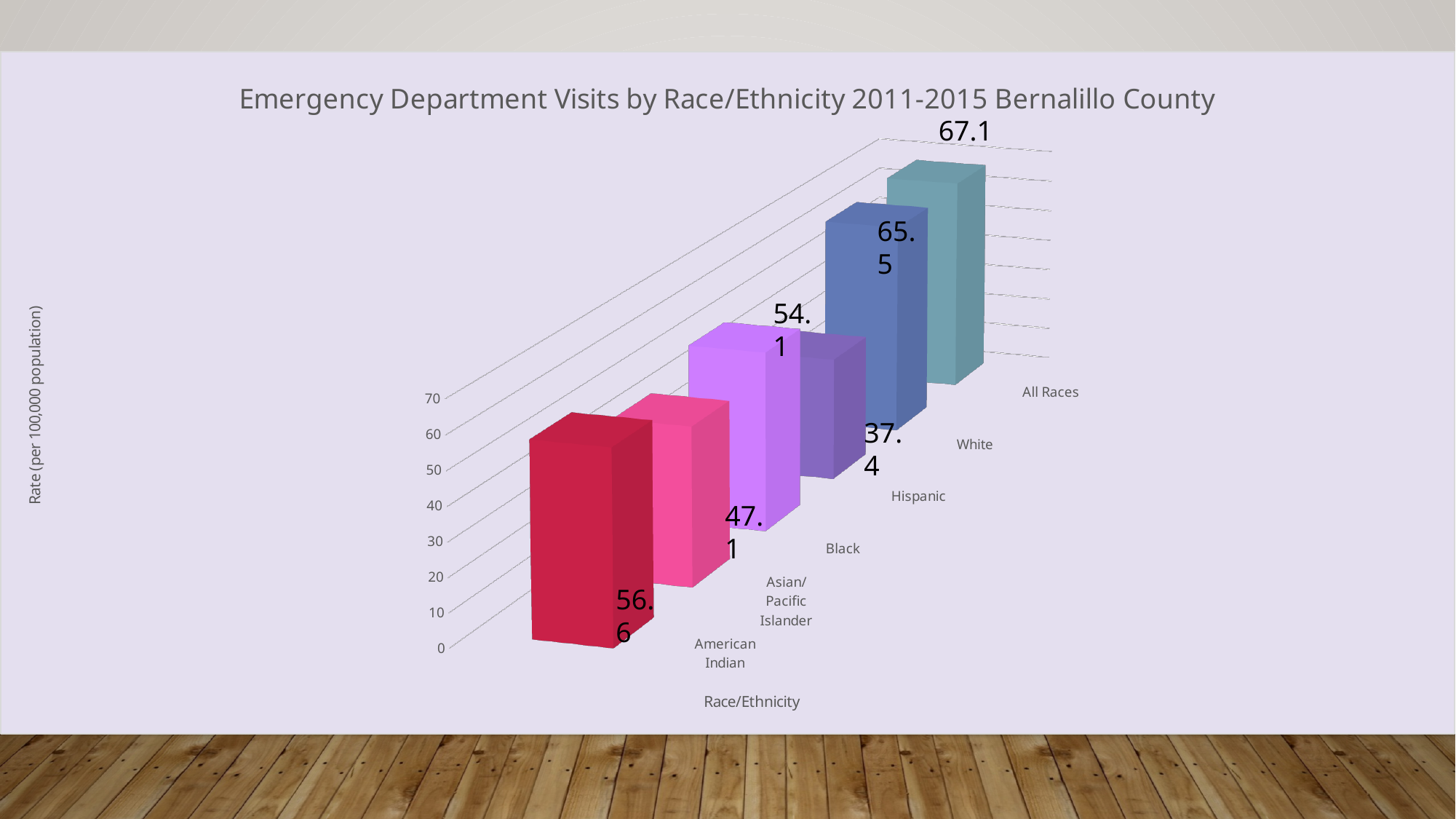
What is the emergency department visit rate for All Races? 67.1 Which category has the highest emergency department visit rate? All Races What is the difference between the rates for White and Hispanic? 28.1 What is the emergency department visit rate for Hispanic? 37.4 What is the label of the vertical axis? Rate (per 100,000 population) What kind of chart is shown on the slide? Bar chart How many race/ethnicity categories are shown in the chart? 6 Which race/ethnicity category has the lowest emergency department visit rate? Hispanic What is the emergency department visit rate for White? 65.5 What is the emergency department visit rate for American Indian? 56.6 Is the value for Asian/Pacific Islander greater or less than 50? less Which has a higher emergency department visit rate, Black or Asian/Pacific Islander? Black